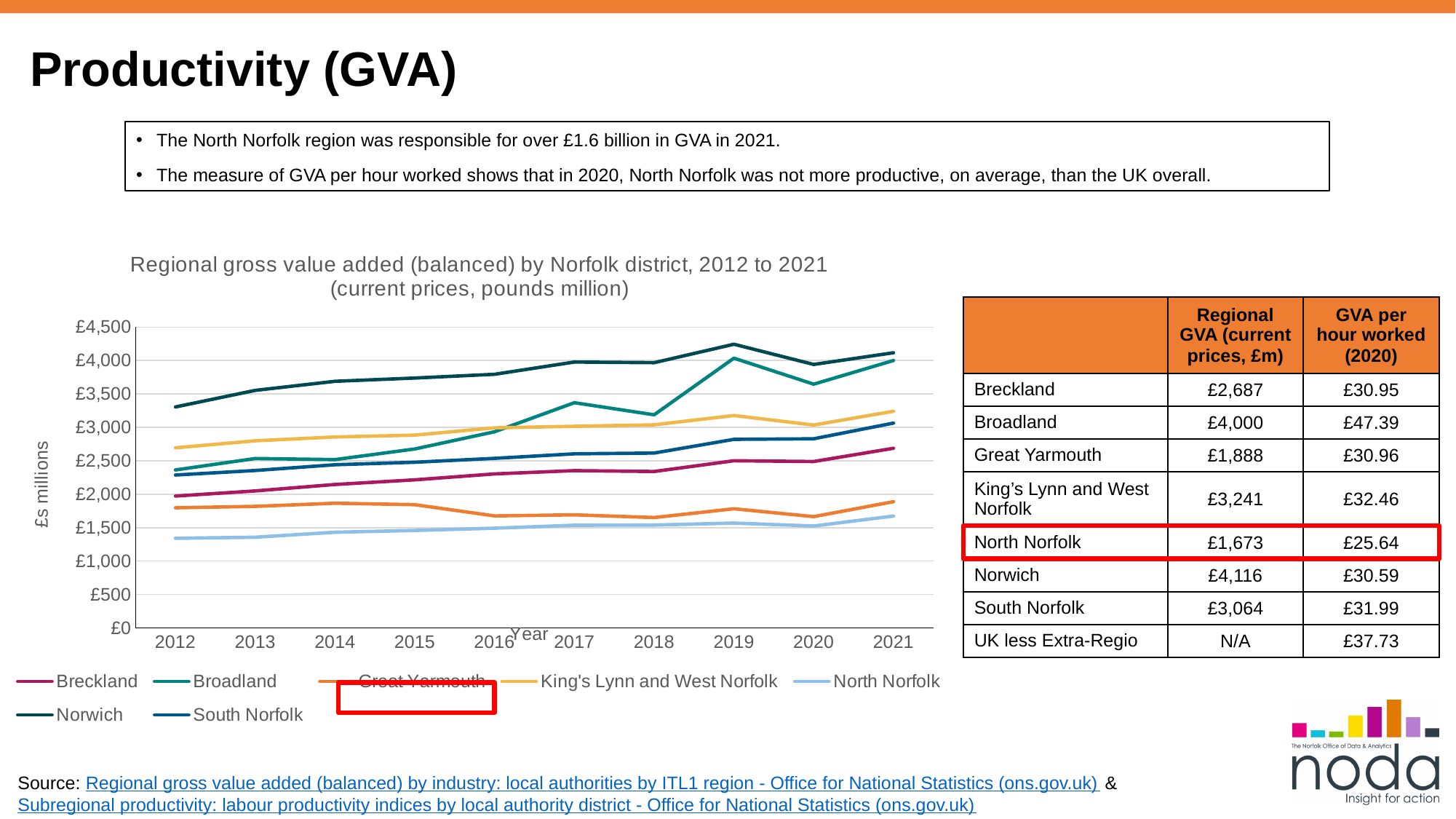
How many years are plotted along the x axis of the chart? 10 Is the value for Norwich in 2019 greater or less than £4,000? greater What kind of chart is shown on the slide? line chart What is the label on the y axis of the chart? £s millions Is the value for Great Yarmouth in 2021 greater or less than £2,000? less Is the value for North Norfolk in 2012 greater or less than £1,500? less Does the Norwich line rise or fall overall from 2012 to 2021? rise In 2019, which is larger: the value for Broadland or the value for King's Lynn and West Norfolk? Broadland Which district has the lowest GVA line in 2012? North Norfolk Which district has the highest GVA line in 2012? Norwich How many series does the chart legend list? 7